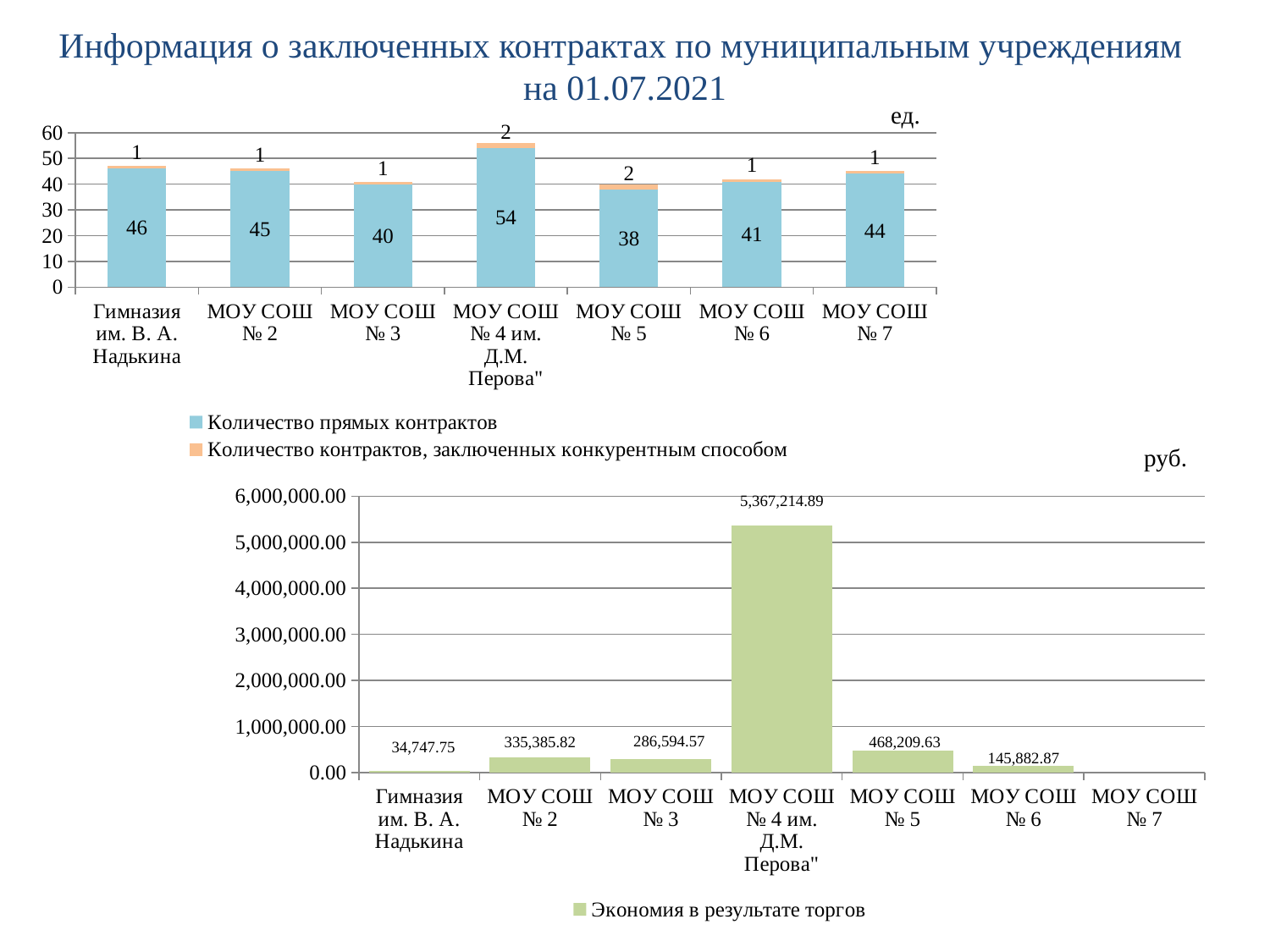
In the bottom chart, which is larger: the savings for МОУ СОШ № 2 or for МОУ СОШ № 3? МОУ СОШ № 2 In the top chart, what is the total number of contracts (both series) for Гимназия им. В. А. Надькина? 47 How many series does the legend of the top chart list? 2 In the bottom chart, what is the savings from bidding (Экономия в результате торгов) for МОУ СОШ № 5? 468,209.63 In the top chart, which institution has the lowest number of direct contracts? МОУ СОШ № 5 How many institutions are shown on the x axis of the top chart? 7 In the top chart, which institution has the highest number of direct contracts? МОУ СОШ № 4 им. Д.М. Перова In the bottom chart, which institution has the highest savings from bidding? МОУ СОШ № 4 им. Д.М. Перова What type of chart is the bottom chart? Bar chart In the top chart, how many direct contracts (Количество прямых контрактов) does МОУ СОШ № 4 им. Д.М. Перова have? 54 In the top chart, how many contracts concluded by competitive method (Количество контрактов, заключенных конкурентным способом) does МОУ СОШ № 5 have? 2 In the top chart, what is the difference in direct contracts between МОУ СОШ № 2 and МОУ СОШ № 3? 5